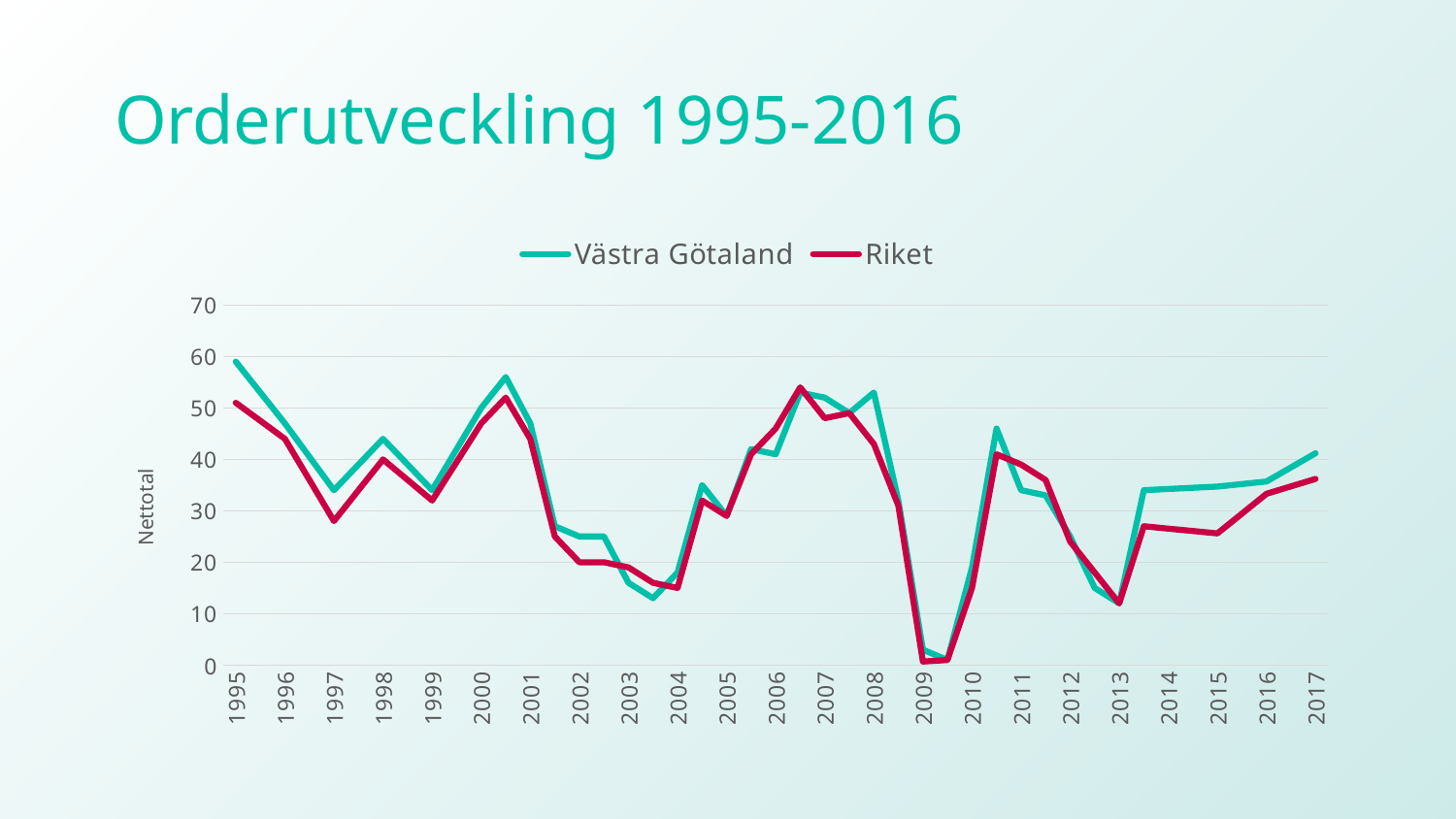
Which series has the higher value in 1995, Västra Götaland or Riket? Västra Götaland Is the value for Västra Götaland in 2003 greater or less than 20? less What is the label on the y axis? Nettotal What kind of chart is shown on the slide? Line chart Is the value for Riket in 2017 greater or less than 30? greater What is the title of the chart? Orderutveckling 1995-2016 Is the value for Riket in 2013 greater or less than 20? less How many years are labelled on the x axis? 23 How many series does the legend list? 2 In which year do both series reach their lowest value? 2009 Does the Riket series rise or fall from 2013 to 2017? Rise